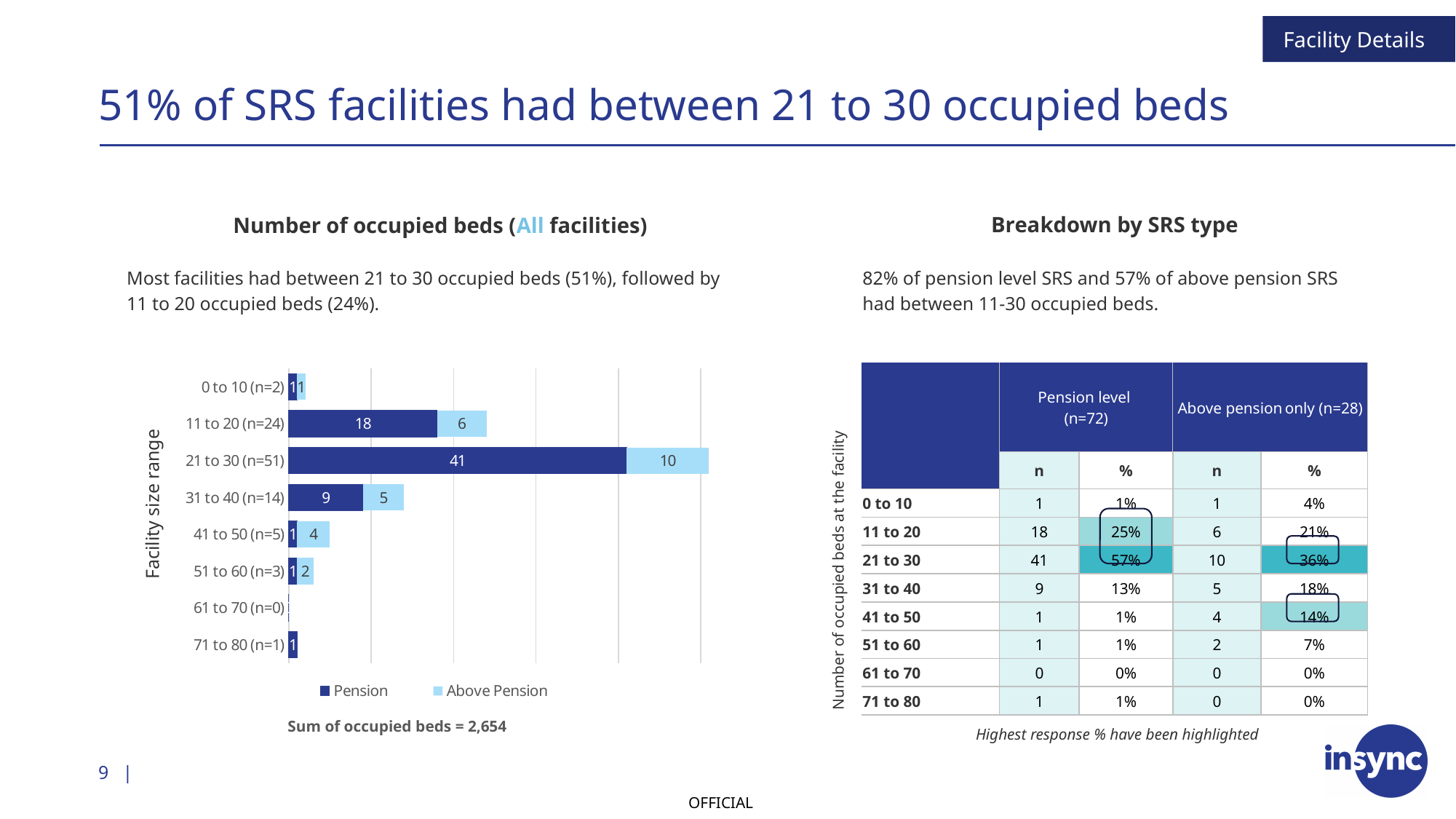
What is the Above Pension value for the 31 to 40 (n=14) category in the occupied beds chart? 5 In the occupied beds chart, for the 41 to 50 (n=5) category, which is larger: Pension or Above Pension? Above Pension How many facility size range categories are shown on the occupied beds chart? 8 What is the Pension value for the 21 to 30 (n=51) category in the occupied beds chart? 41 How many series does the legend of the occupied beds chart list? 2 What is the Above Pension value for the 11 to 20 (n=24) category in the occupied beds chart? 6 Which facility size range has the longest bar in the occupied beds chart? 21 to 30 (n=51) What type of chart is used to show the number of occupied beds for all facilities? Stacked bar chart What is the total of the stacked bar for the 21 to 30 (n=51) category in the occupied beds chart? 51 What is the total of the stacked bar for the 11 to 20 (n=24) category in the occupied beds chart? 24 In the occupied beds chart, what is the difference between the Pension values for 21 to 30 and 11 to 20? 23 What sum of occupied beds is stated below the occupied beds chart? 2,654